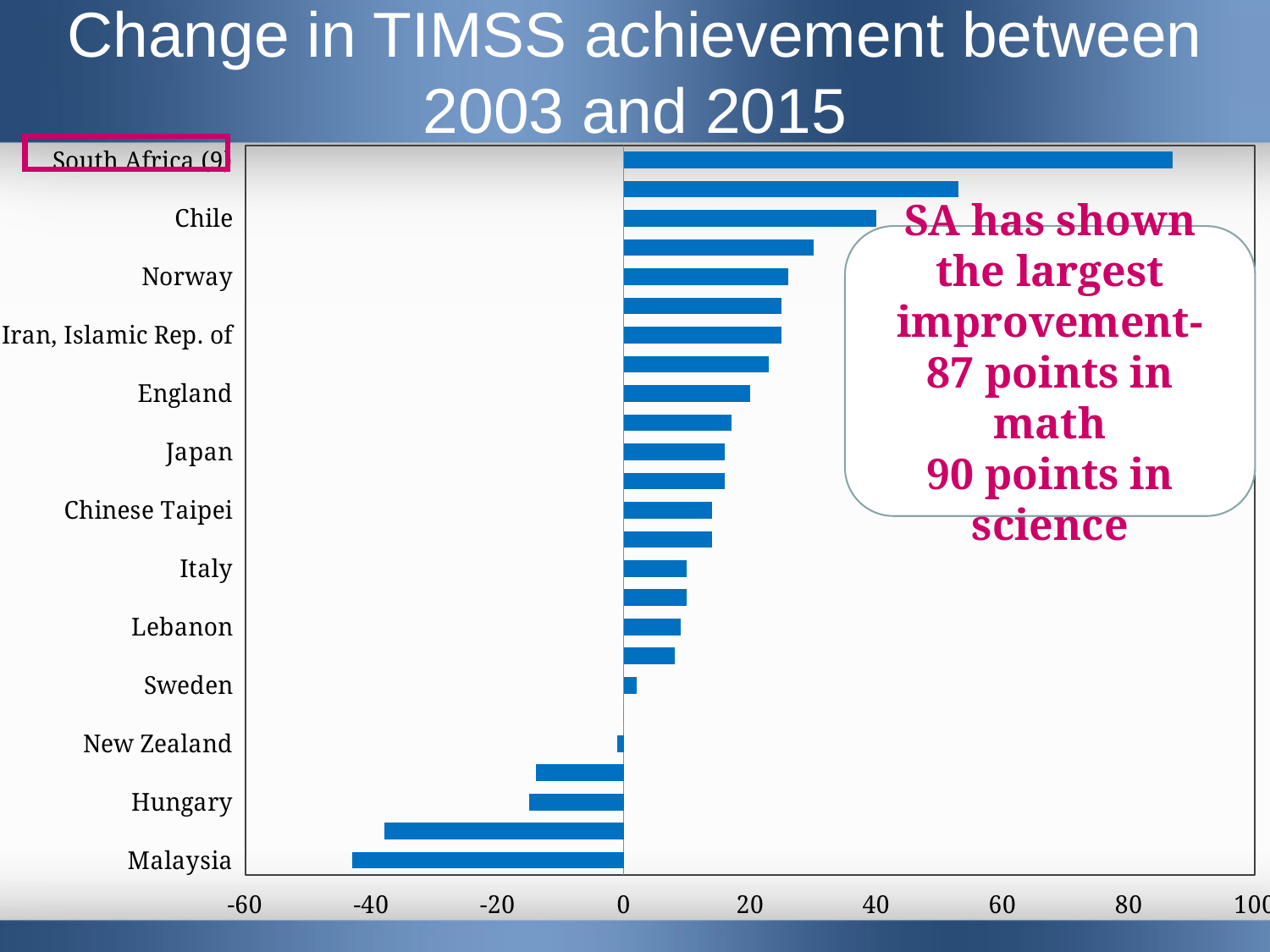
Which has the larger change in achievement, Chile or Norway? Chile Which labelled country shows the lowest (most negative) change in TIMSS achievement? Malaysia Is the value for Chile greater or less than 20? greater Is the value for Hungary greater or less than 0? less Is the value for Norway greater or less than 20? greater Do the bar values increase or decrease going from the top of the chart to the bottom? decrease According to the callout on the slide, by how many points did South Africa improve in math? 87 points What kind of chart is shown on the slide? bar chart Which has the larger change in achievement, Japan or Italy? Japan Which country shows the largest change in TIMSS achievement? South Africa